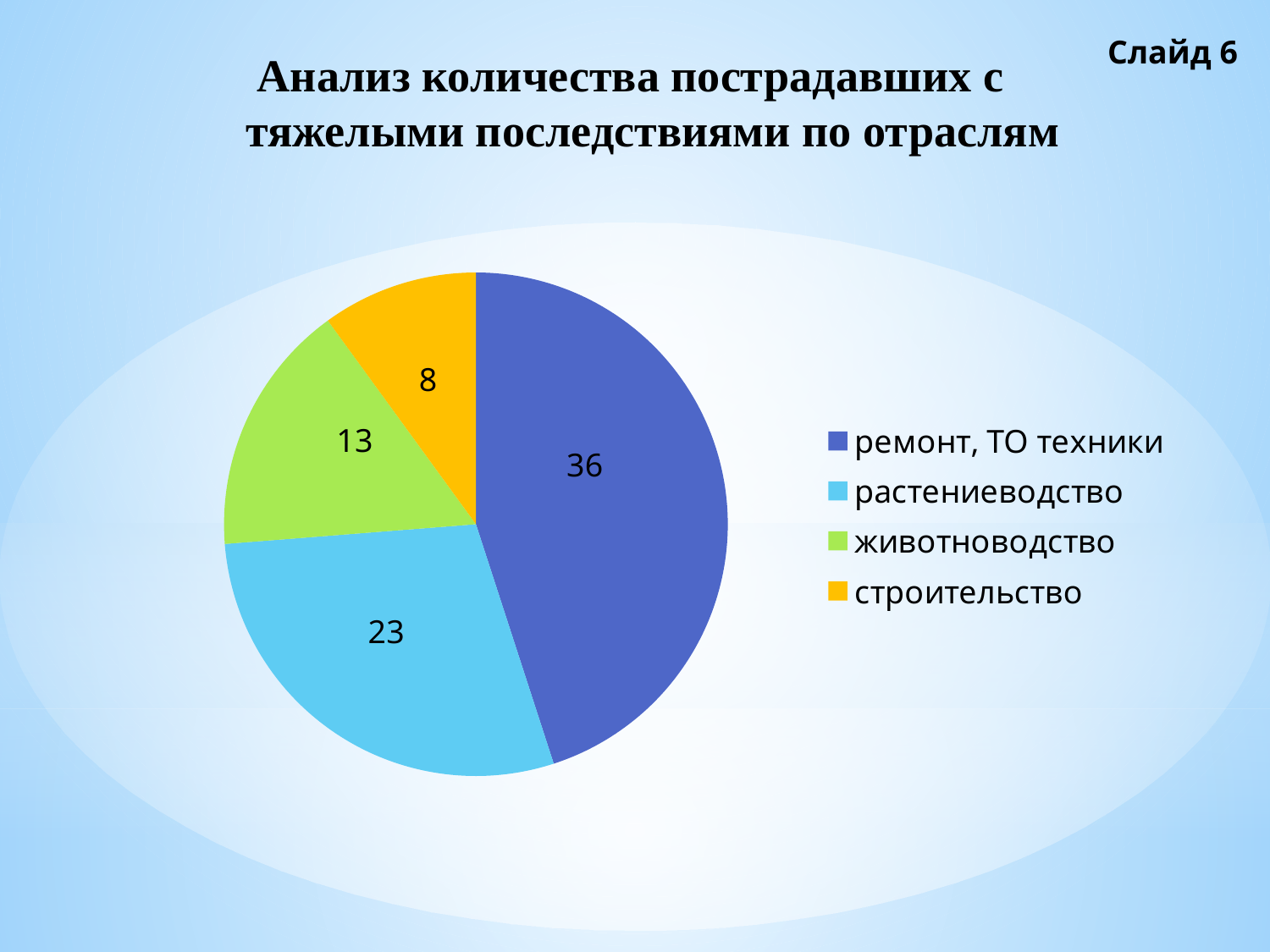
Which category has the smallest slice of the pie? строительство What is the value for ремонт, ТО техники? 36 Which is larger, the value for животноводство or the value for строительство? животноводство What is the value for животноводство? 13 What type of chart is shown on the slide? pie chart Which category has the largest slice of the pie? ремонт, ТО техники How many categories does the pie chart have? 4 What is the difference between the values for ремонт, ТО техники and растениеводство? 13 What is the value for строительство? 8 What is the value for растениеводство? 23 What share of the pie does строительство represent? 10% What is the total of all slices in the pie chart? 80